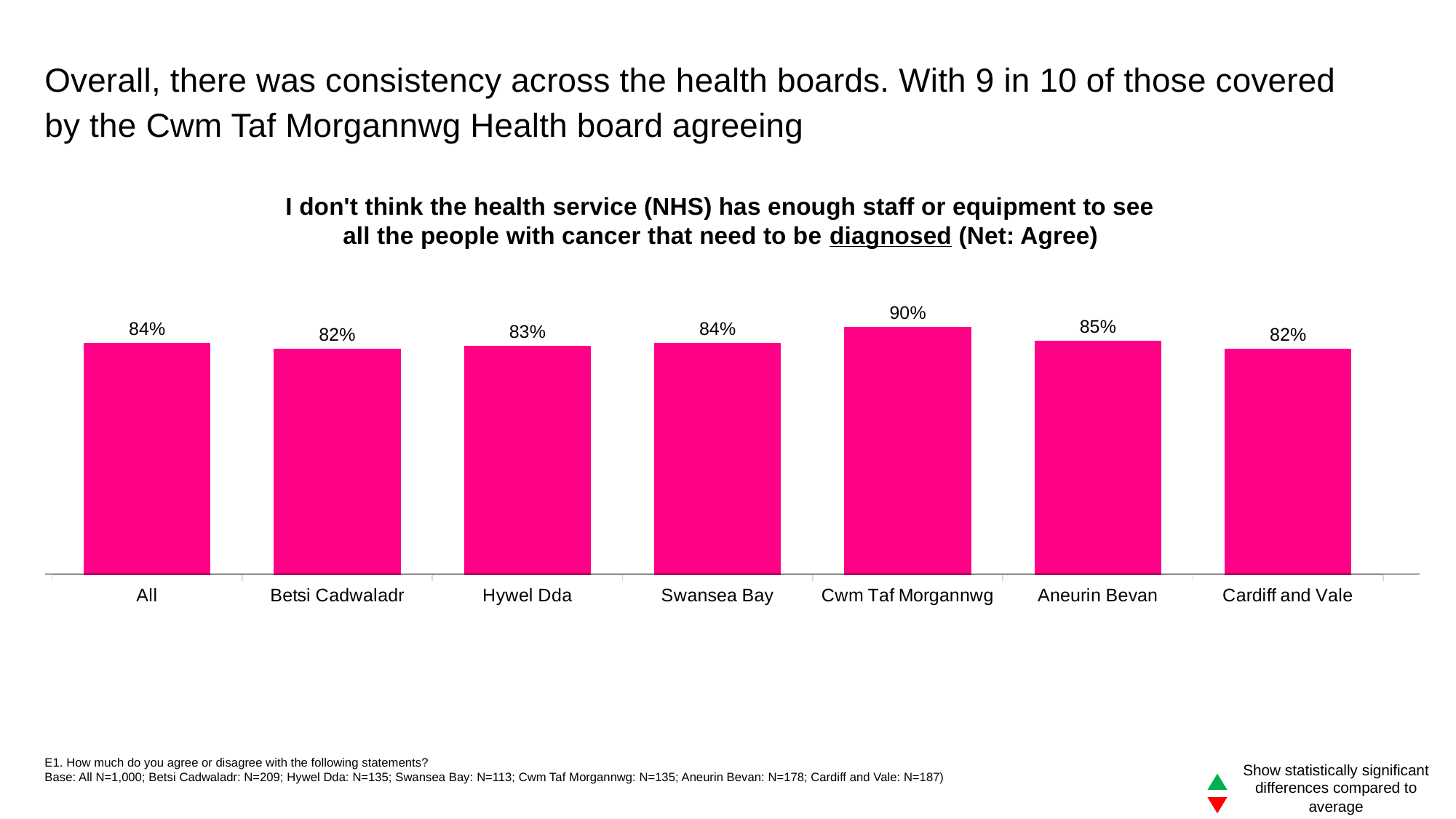
How many categories are shown on the x axis? 7 What is the difference between the values for Cwm Taf Morgannwg and Hywel Dda? 7 percentage points What is the value for the All category? 84% Which two health boards share the lowest value of 82%? Betsi Cadwaladr and Cardiff and Vale What colour are the bars in the chart? Pink Which is larger, the value for Swansea Bay or the value for Hywel Dda? Swansea Bay What is the value for Cwm Taf Morgannwg? 90% What is the difference between the values for Aneurin Bevan and Cardiff and Vale? 3 percentage points What kind of chart is shown on the slide? Bar chart Which health board has the highest value? Cwm Taf Morgannwg What is the value for Aneurin Bevan? 85% What is the value for Betsi Cadwaladr? 82%